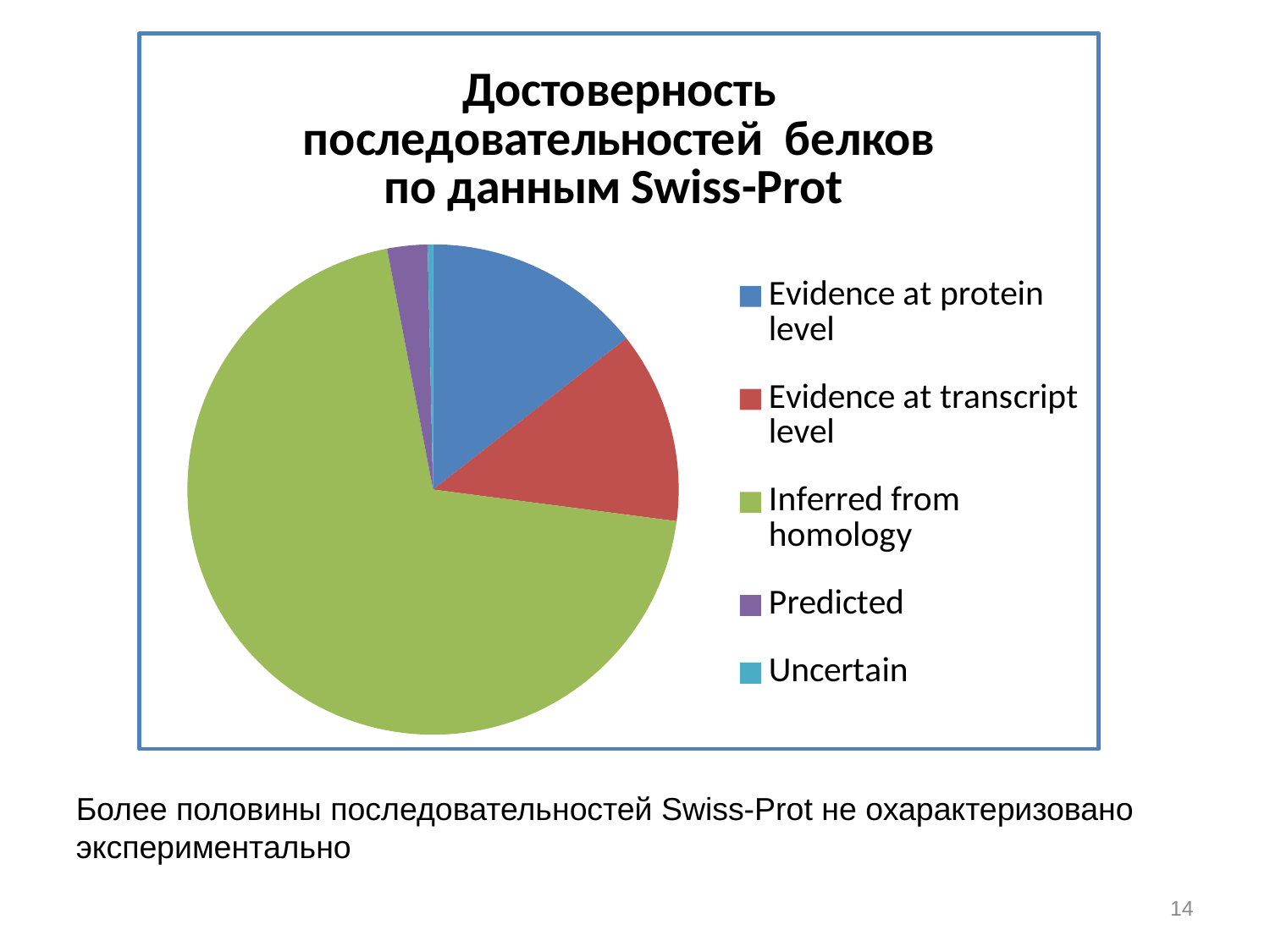
Which category has the largest slice of the pie chart? Inferred from homology Which slice is larger: Inferred from homology or Evidence at protein level? Inferred from homology Which category has the smallest slice of the pie chart? Uncertain Which slice is larger: Evidence at protein level or Predicted? Evidence at protein level How many entries does the legend of the pie chart list? 5 Which slice is larger: Predicted or Uncertain? Predicted What colour is the Inferred from homology slice in the pie chart? green Is the share of the pie for Inferred from homology greater or less than 50%? greater What is the title of the pie chart? Достоверность последовательностей белков по данным Swiss-Prot How many categories (slices) does the pie chart have? 5 What kind of chart is shown on the slide? pie chart